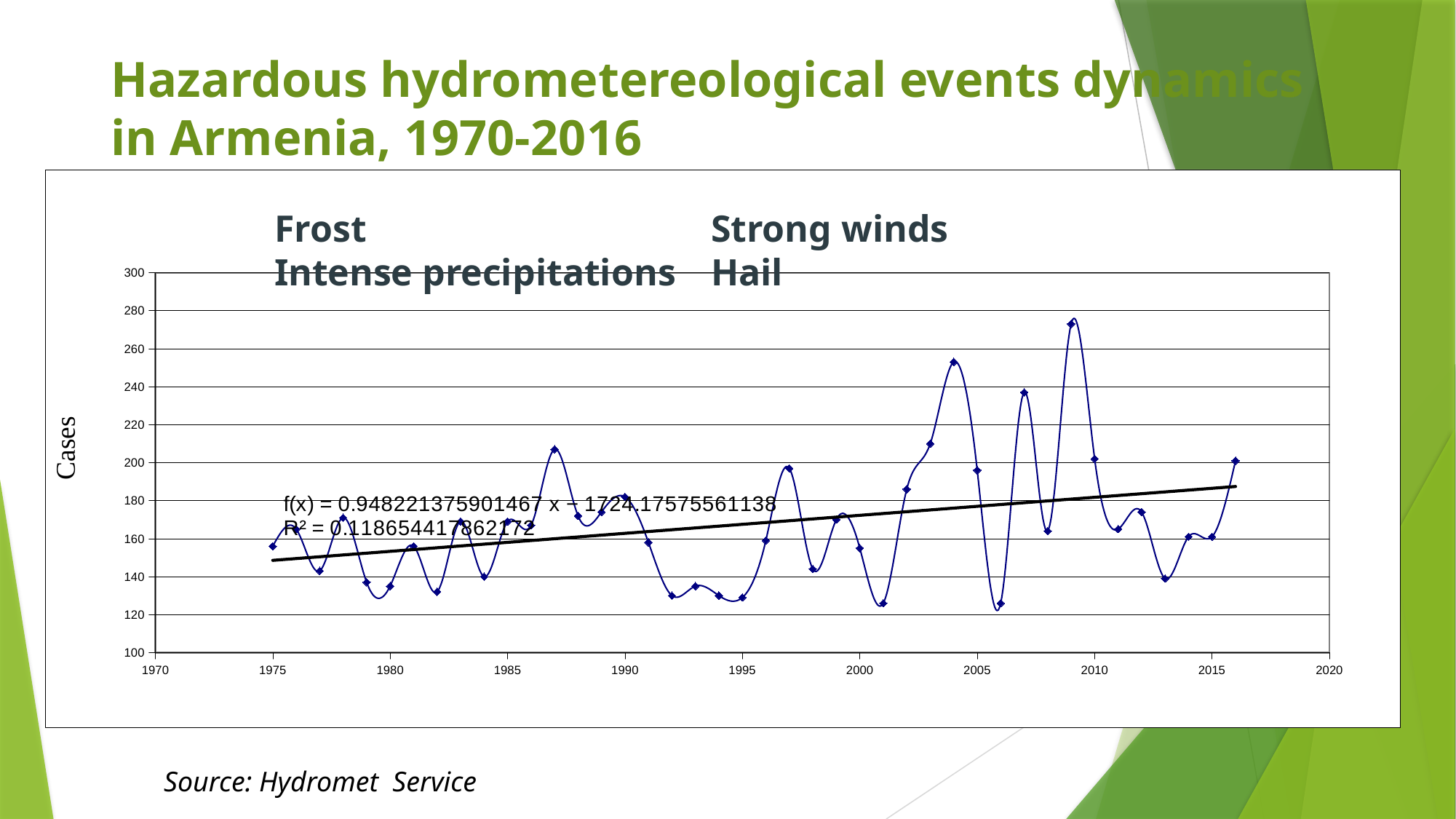
What is the label on the vertical axis of the chart? Cases Which year has the larger value, 1987 or 1992? 1987 Is the value for 2009 greater or less than 260? greater Is the value for 2001 greater or less than 140? less Is the value for 2013 greater or less than 160? less Which year has the highest number of cases? 2009 What kind of chart is shown on the slide? line chart What R² value is printed on the chart for the trendline? 0.118654417862172 According to the trendline, do the number of cases rise or fall over the period 1975-2016? rise